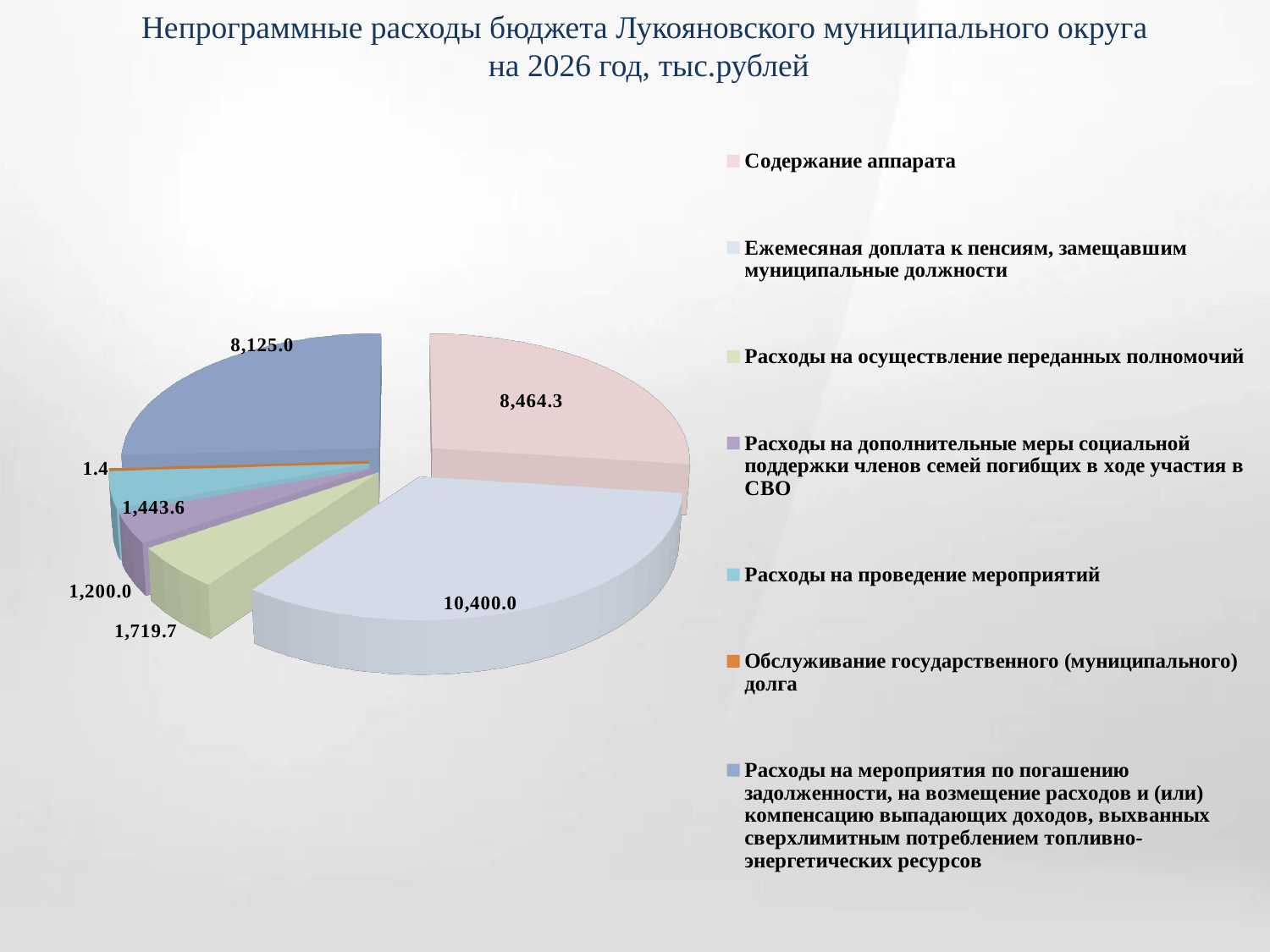
How many categories does the pie chart contain? 7 What is the value for «Ежемесяная доплата к пенсиям, замещавшим муниципальные должности»? 10,400.0 What is the value for «Расходы на осуществление переданных полномочий»? 1,719.7 What is the value for «Расходы на проведение мероприятий»? 1,443.6 Which is larger: the value for «Расходы на дополнительные меры социальной поддержки членов семей погибших в ходе участия в СВО» or the value for «Расходы на проведение мероприятий»? Расходы на проведение мероприятий What is the value for «Содержание аппарата»? 8,464.3 What type of chart is shown on the slide? Pie chart Which category has the largest value in the pie chart? Ежемесяная доплата к пенсиям, замещавшим муниципальные должности What is the value for «Обслуживание государственного (муниципального) долга»? 1.4 What is the title of the chart on the slide? Непрограммные расходы бюджета Лукояновского муниципального округа на 2026 год, тыс.рублей Which category has the smallest value in the pie chart? Обслуживание государственного (муниципального) долга What is the difference between the values for «Ежемесяная доплата к пенсиям, замещавшим муниципальные должности» and «Содержание аппарата»? 1,935.7